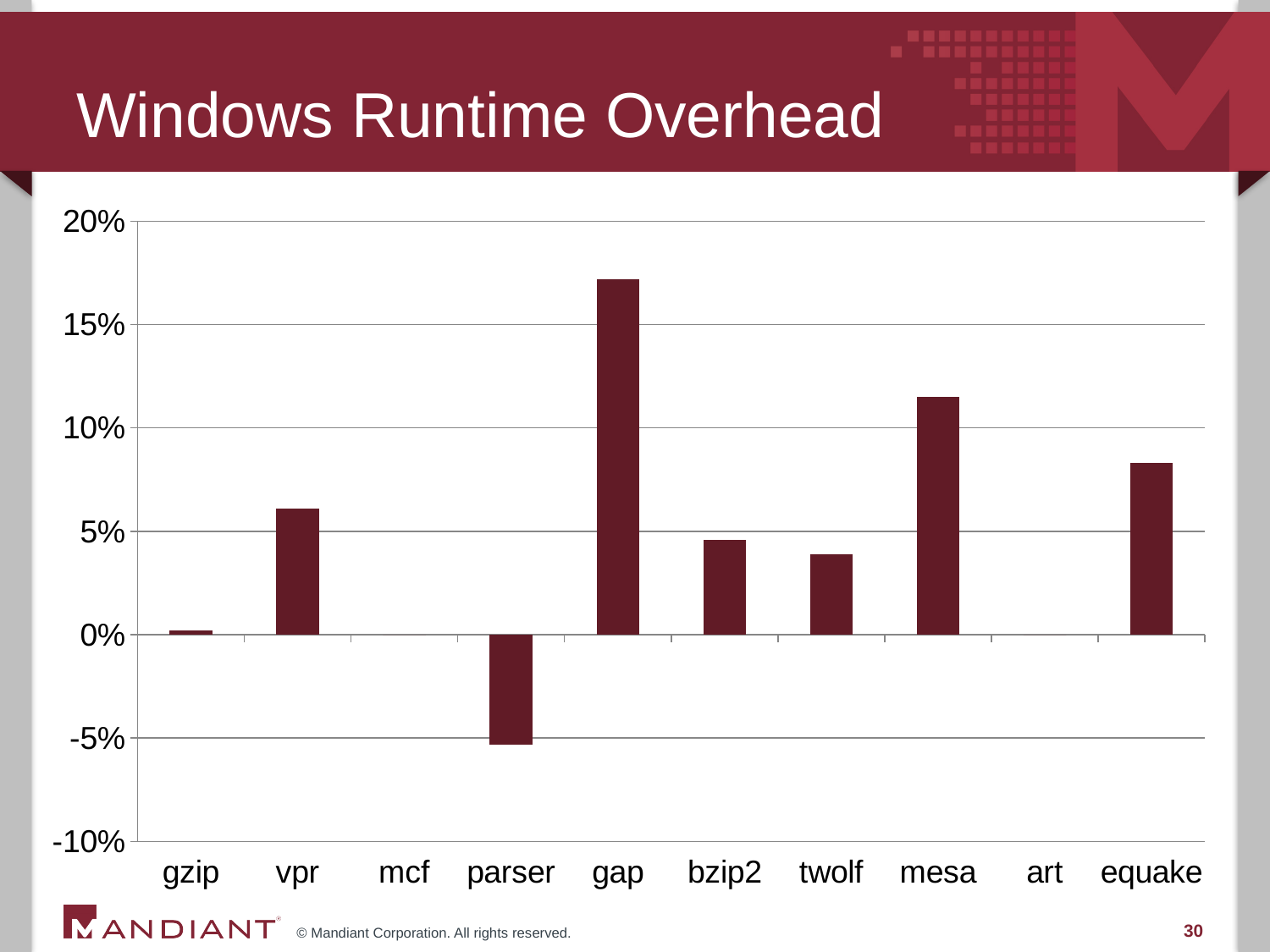
What kind of chart is shown on the slide? bar chart Is the value for parser greater or less than 0%? less Is the value for mesa greater or less than 10%? greater Which category has the highest value? gap What is the title of the chart? Windows Runtime Overhead Which category has the lowest value? parser Is the value for twolf greater or less than 5%? less How many categories are shown on the x axis? 10 Which category is the only one with a negative value? parser Which is larger, the value for mesa or the value for equake? mesa